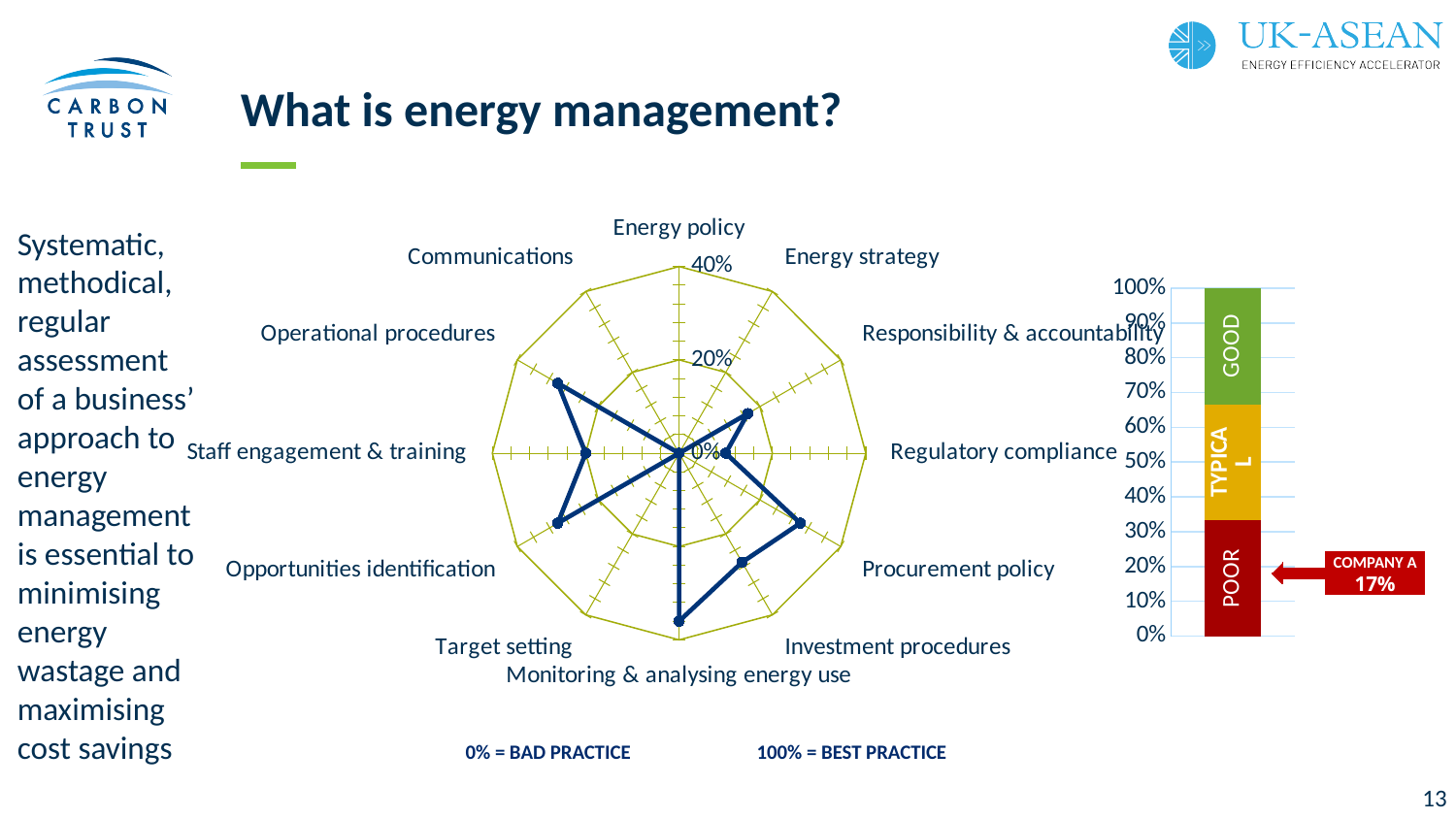
On the bar scale at the right of the slide, which band does Company A's score fall into? POOR On the radar chart, which category has the highest value? Monitoring & analysing energy use On the radar chart, is the value for Procurement policy greater or less than 20%? greater How many categories (axes) does the radar chart have? 12 What kind of chart is the large chart in the centre of the slide? Radar chart On the radar chart, is the value for Energy policy greater or less than 20%? less On the radar chart, which is larger: the value for Procurement policy or the value for Energy strategy? Procurement policy What are the three bands labelled on the bar scale at the right of the slide? POOR, TYPICAL, GOOD What is the highest percentage shown on the radar chart's axis scale? 40% On the radar chart, is the value for Monitoring & analysing energy use greater or less than 20%? greater On the bar scale at the right of the slide, what score is shown for Company A? 17%